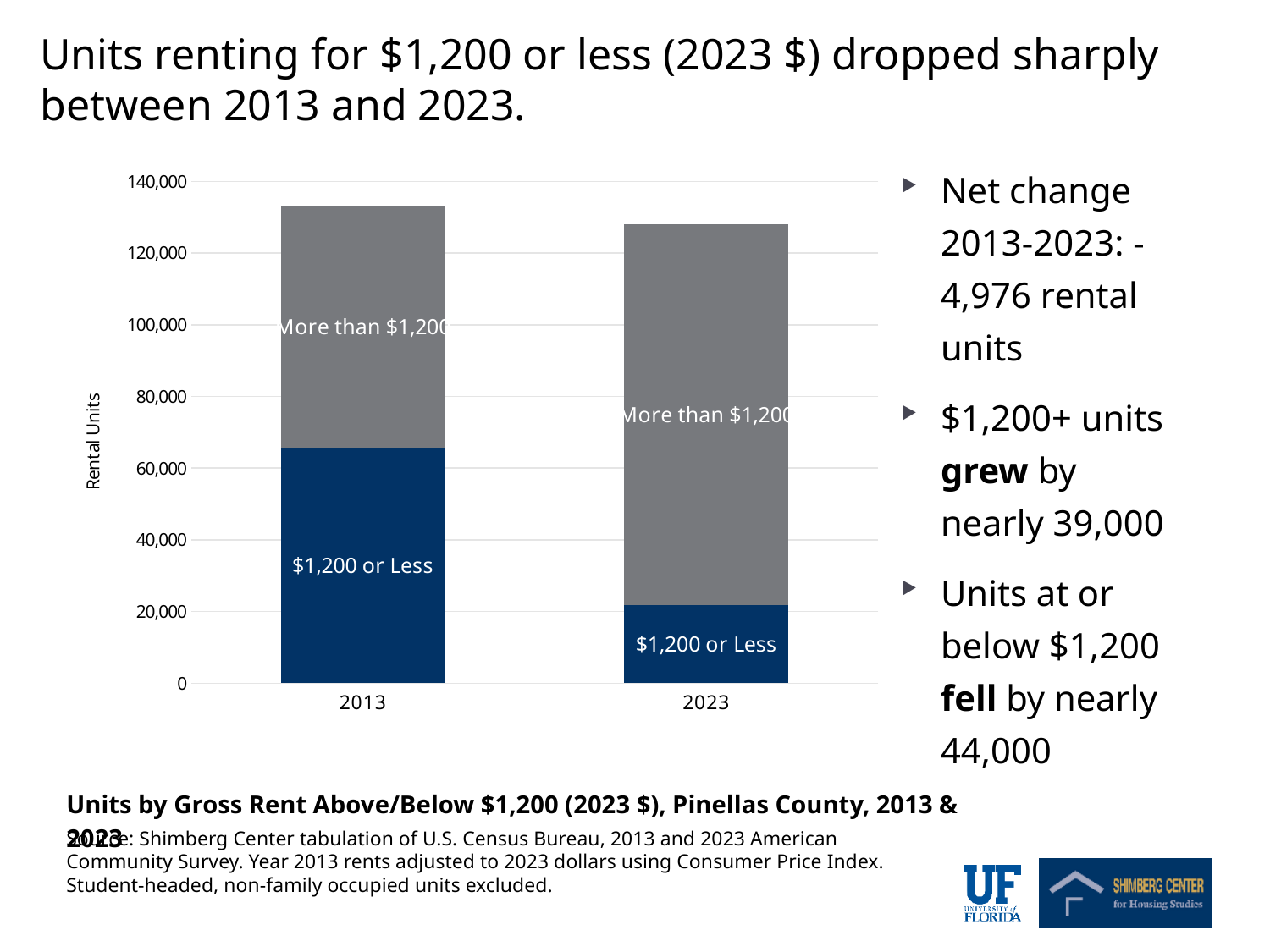
What kind of chart is shown on the slide? Stacked bar chart How many years (categories) are shown on the x axis of the chart? 2 Which year has the larger "More than $1,200" segment, 2013 or 2023? 2023 Is the value for "$1,200 or Less" units in 2013 greater or less than 60,000? greater Does the number of "$1,200 or Less" units rise or fall from 2013 to 2023? Fall What is the label on the y axis of the chart? Rental Units How many rent segments make up each stacked bar in the chart? 2 Is the total height of the 2023 bar greater or less than 140,000? less Is the total height of the 2013 bar greater or less than 120,000? greater What colour is the "$1,200 or Less" segment in the chart? Dark blue Which year has the larger "$1,200 or Less" segment, 2013 or 2023? 2013